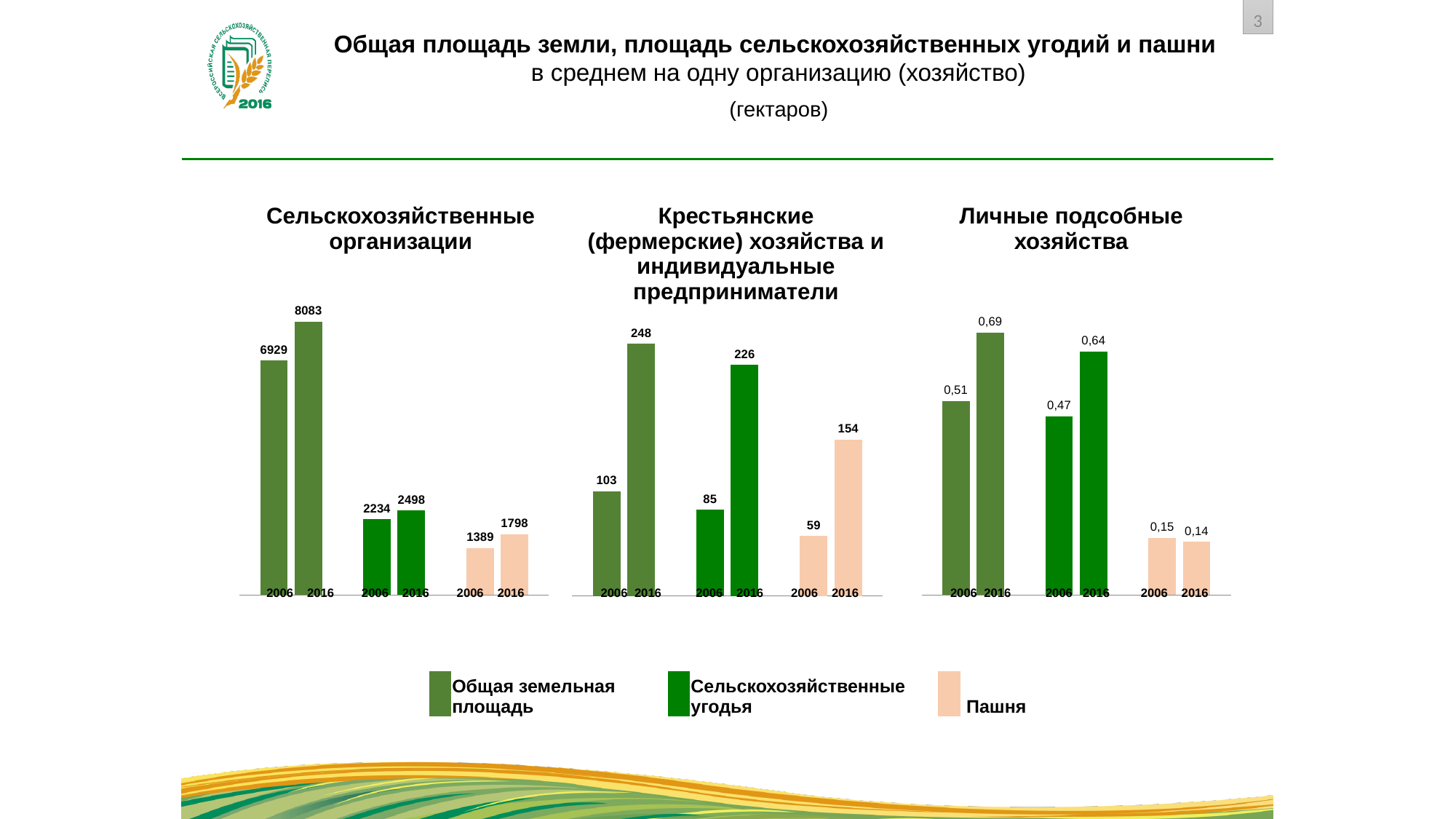
In the chart titled "Сельскохозяйственные организации", by how much did "Сельскохозяйственные угодья" change from 2006 to 2016? 264 In the chart titled "Сельскохозяйственные организации", what is the value of "Пашня" for 2006? 1389 In the chart titled "Крестьянские (фермерские) хозяйства и индивидуальные предприниматели", what is the value of "Общая земельная площадь" for 2016? 248 How many series does the legend list? 3 In the chart titled "Личные подсобные хозяйства", which is larger: "Пашня" in 2006 or in 2016? 2006 What type of chart is used on this slide? bar chart In the chart titled "Крестьянские (фермерские) хозяйства и индивидуальные предприниматели", what is the value of "Пашня" for 2006? 59 In the chart titled "Личные подсобные хозяйства", what is the value of "Общая земельная площадь" for 2006? 0,51 In the chart titled "Сельскохозяйственные организации", what is the value of "Общая земельная площадь" for 2016? 8083 In the chart titled "Крестьянские (фермерские) хозяйства и индивидуальные предприниматели", what is the difference between "Сельскохозяйственные угодья" in 2016 and 2006? 141 In the chart titled "Личные подсобные хозяйства", which bar has the highest value? Общая земельная площадь, 2016 In the chart titled "Личные подсобные хозяйства", does "Пашня" rise or fall from 2006 to 2016? fall